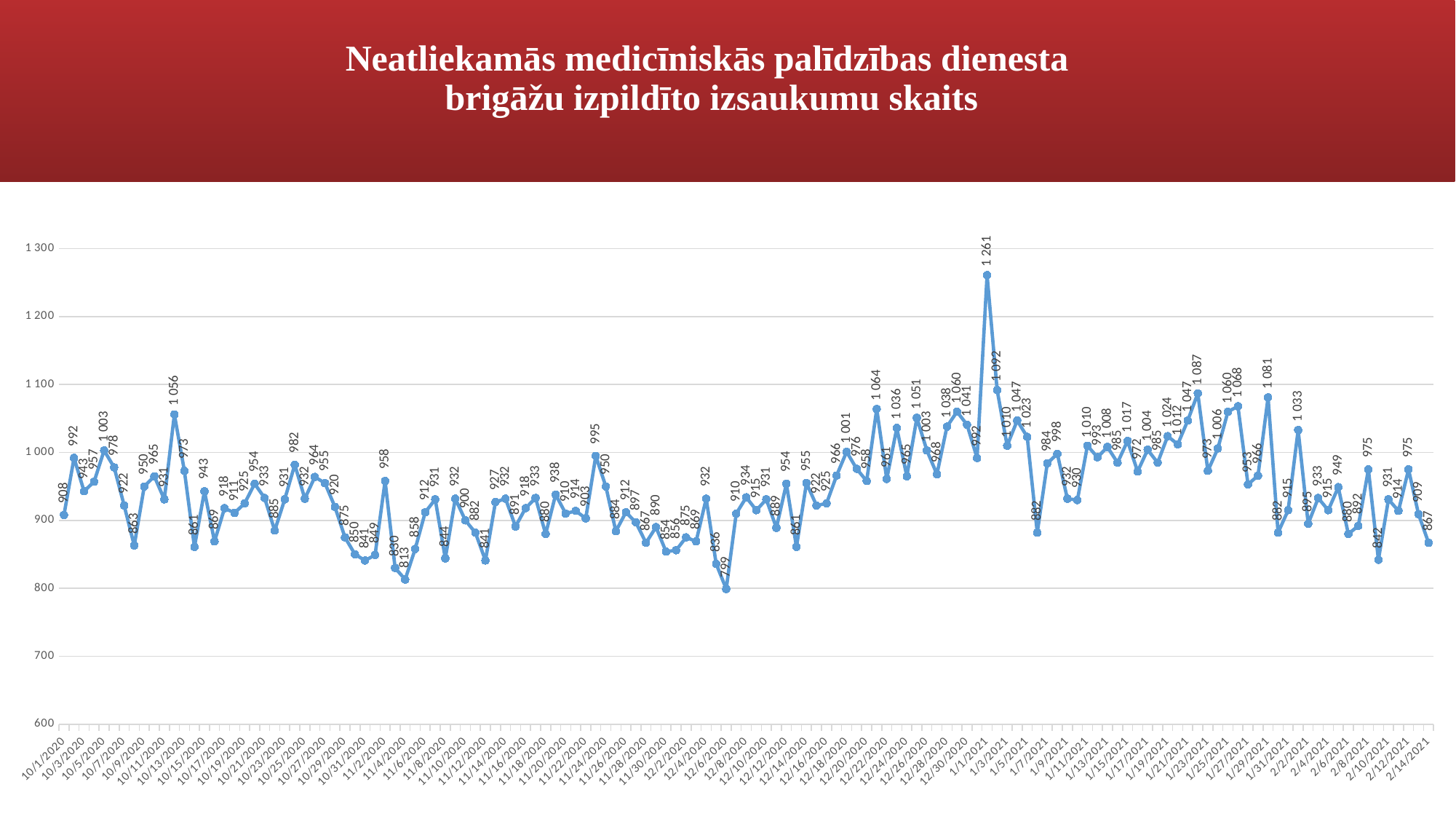
What is the difference between the highest value (1 261) and the lowest value (799) on the chart? 462 What kind of chart is shown on the slide? line chart Is the value for 10/1/2020 greater or less than 1 000? less What is the title of the chart on the slide? Neatliekamās medicīniskās palīdzības dienesta brigāžu izpildīto izsaukumu skaits What is the highest value plotted on the chart? 1 261 What is the value for 10/1/2020, the first point on the chart? 908 What is the lowest value shown on the vertical axis? 600 On which date does the chart reach its highest value? 1/1/2021 What is the value for 2/14/2021, the last point on the chart? 867 What is the lowest value plotted on the chart? 799 Is the value for 1/1/2021 greater or less than 1 200? greater Which is larger, the value for 1/1/2021 or the value for 10/1/2020? 1/1/2021